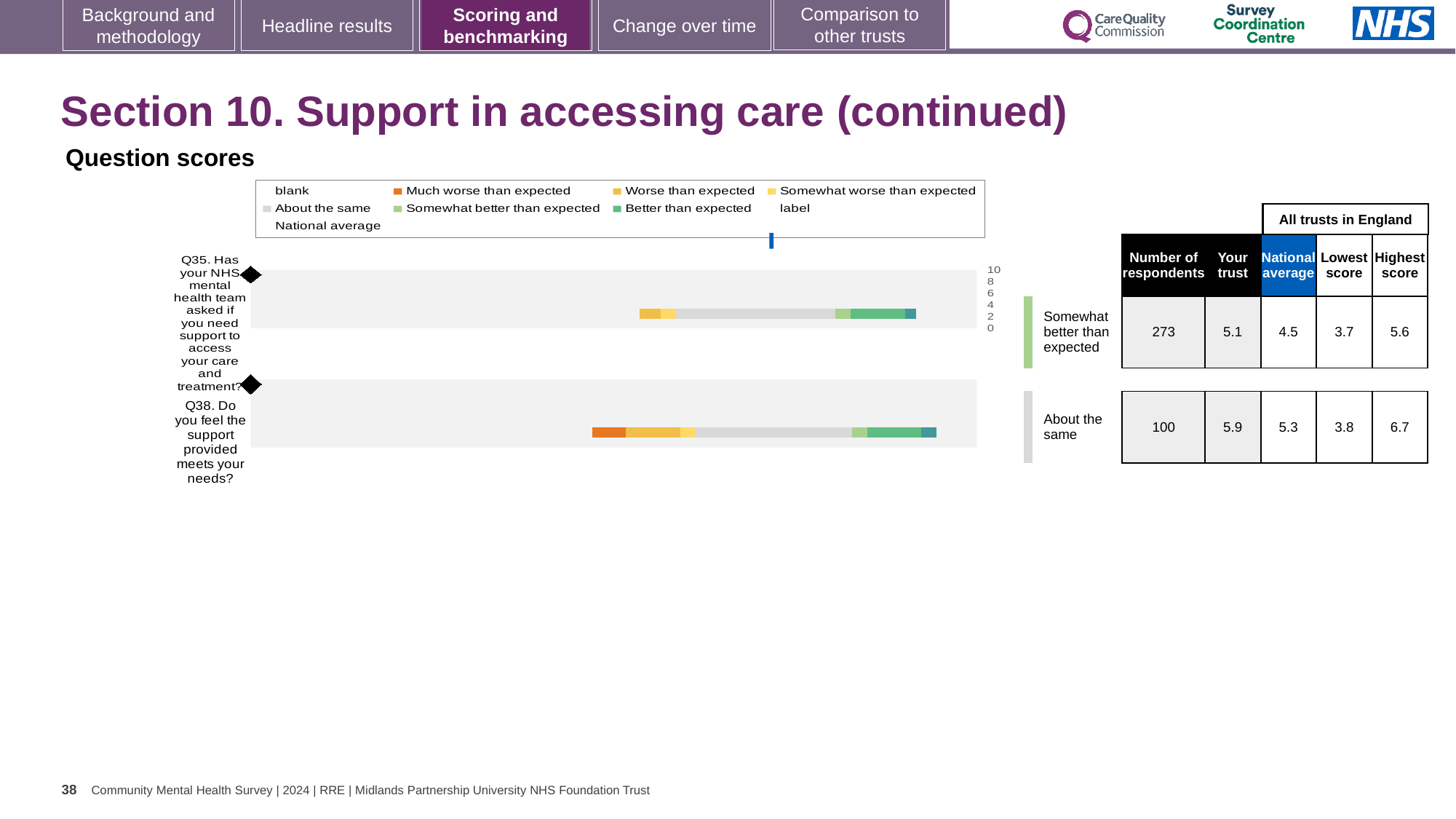
What kind of chart is used to show the question scores on this slide? Horizontal stacked bar chart Which benchmark category is shown for Q38 (Do you feel the support provided meets your needs?)? About the same In the table next to the chart, what is the number of respondents for Q35? 273 In the table next to the chart, what is the national average for Q35? 4.5 What is the difference between the 'Your trust' scores for Q38 and Q35? 0.8 How many questions (bars) are plotted in the question scores chart? 2 In the table next to the chart, what is the 'Your trust' score for Q38? 5.9 In the table next to the chart, what is the lowest score across all trusts in England for Q35? 3.7 What is the difference between the 'Your trust' score and the national average for Q35? 0.6 In the table next to the chart, what is the highest score across all trusts in England for Q38? 6.7 Which question has the higher 'Your trust' score, Q35 or Q38? Q38 Which benchmark category is shown for Q35 (Has your NHS mental health team asked if you need support to access your care and treatment?)? Somewhat better than expected